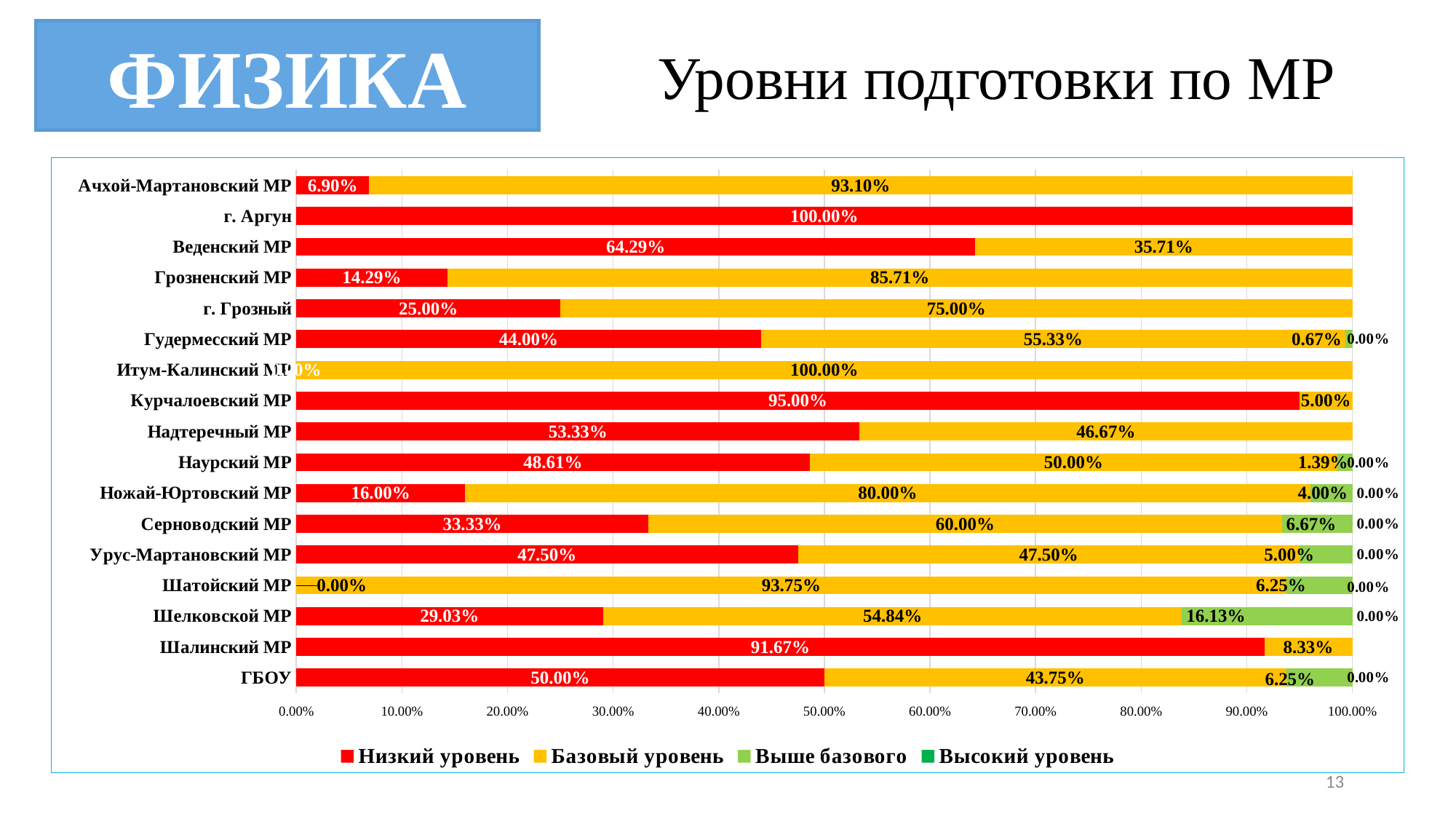
What is the value of Низкий уровень for г. Грозный? 25.00% Which category has the highest value for Низкий уровень? г. Аргун What is the value of Низкий уровень for Веденский МР? 64.29% What is the value of Выше базового for Шелковской МР? 16.13% How many series does the legend list? 4 Which is larger for Низкий уровень: Курчалоевский МР or Шалинский МР? Курчалоевский МР Which category has the highest value for Выше базового? Шелковской МР What is the value of Базовый уровень for Итум-Калинский МР? 100.00% What kind of chart is shown on the slide? Stacked bar chart How many categories are shown on the chart? 17 What is the value of Базовый уровень for Грозненский МР? 85.71% What is the difference between Низкий уровень and Базовый уровень for Надтеречный МР? 6.66%